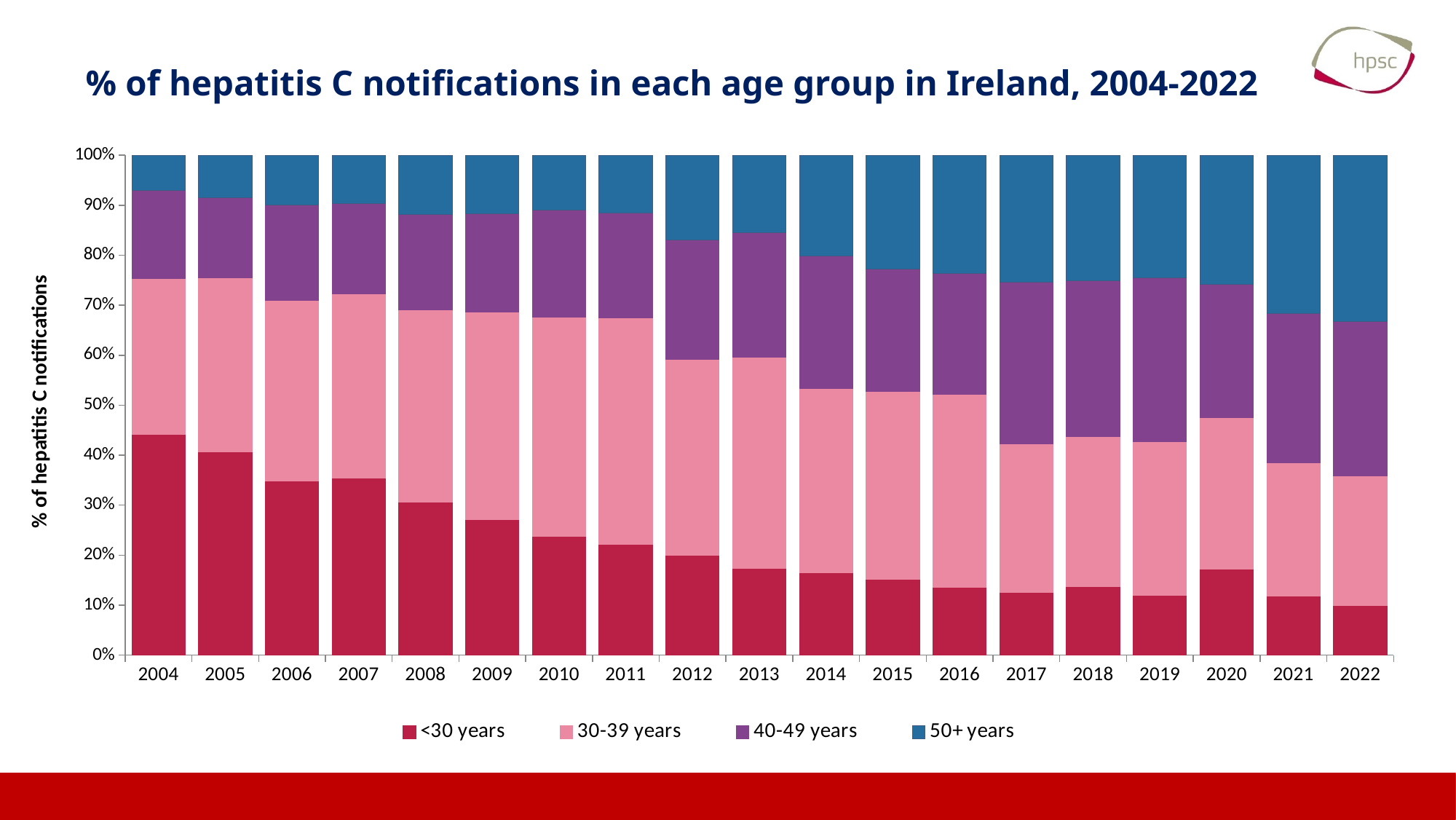
Is the share of the <30 years age group in 2022 greater or less than 20%? less How many age groups does the legend list? 4 What is the label on the y axis? % of hepatitis C notifications In which year is the share of the <30 years age group highest? 2004 Does the share of notifications in the 50+ years age group generally rise or fall from 2004 to 2022? Rise How many years are shown along the x axis? 19 Which year has a larger share of notifications in the 50+ years age group, 2004 or 2022? 2022 Is the share of the <30 years age group in 2004 greater or less than 40%? greater Is the share of the 50+ years age group in 2004 greater or less than 10%? less What kind of chart is shown on the slide? Stacked bar chart What does each stacked bar total? 100% Does the share of notifications in the <30 years age group generally rise or fall from 2004 to 2022? Fall